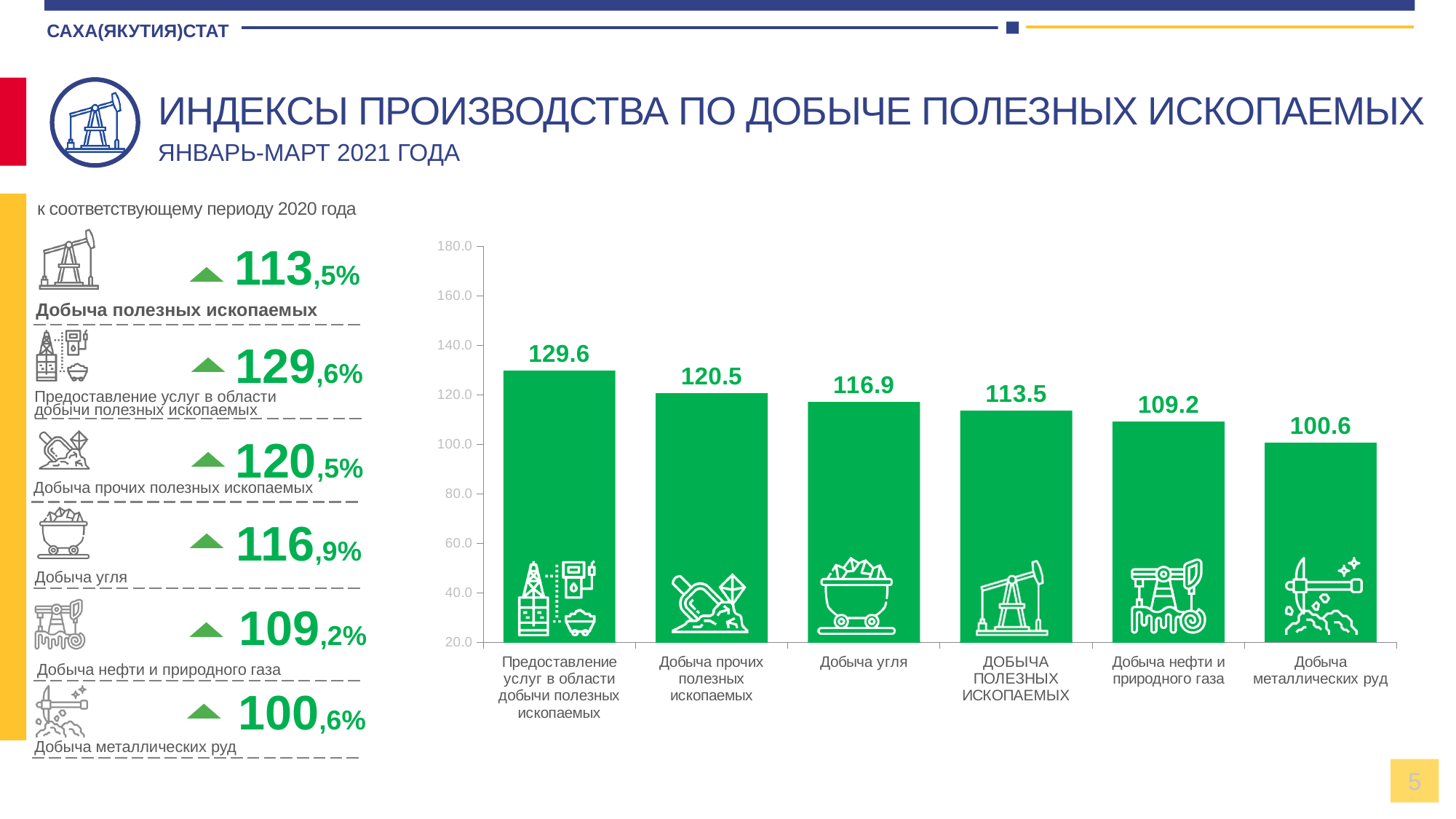
What kind of chart is shown on the slide? bar chart Which category has the lowest value? Добыча металлических руд What is the value for Предоставление услуг в области добычи полезных ископаемых? 129.6 What is the difference between the values for Добыча прочих полезных ископаемых and Добыча угля? 3.6 Which is larger, the value for ДОБЫЧА ПОЛЕЗНЫХ ИСКОПАЕМЫХ or the value for Добыча нефти и природного газа? ДОБЫЧА ПОЛЕЗНЫХ ИСКОПАЕМЫХ What is the value for Добыча металлических руд? 100.6 Is the value for Добыча прочих полезных ископаемых greater or less than 120.0? greater What is the value for Добыча угля? 116.9 Do the values rise or fall from left to right along the x axis? fall How many categories are shown in the bar chart? 6 What is the value for Добыча нефти и природного газа? 109.2 Which category has the highest value? Предоставление услуг в области добычи полезных ископаемых